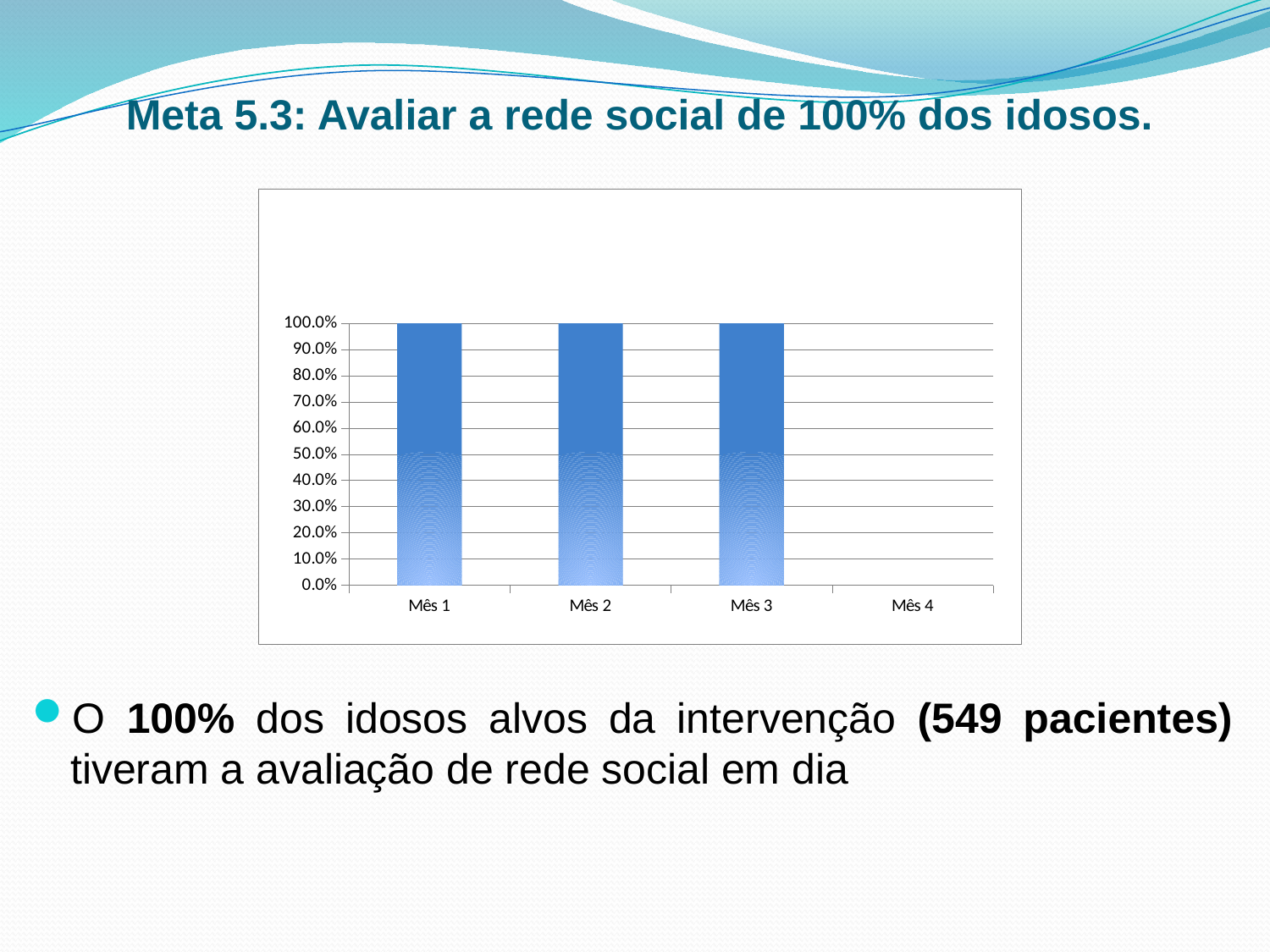
Which is larger, the value for Mês 1 or the value for Mês 4? Mês 1 What is the highest value labelled on the y axis of the chart? 100.0% What kind of chart is shown on the slide? bar chart Which category has the lowest value in the chart? Mês 4 What is the difference between the values for Mês 1 and Mês 2? 0.0% How many categories are shown on the x axis of the chart? 4 Which category on the x axis has no bar drawn? Mês 4 Is the value for Mês 2 greater or less than 50.0%? greater What is the value for Mês 1? 100.0% Do the values rise, fall or stay the same from Mês 1 to Mês 3? stay the same What is the value for Mês 3? 100.0%